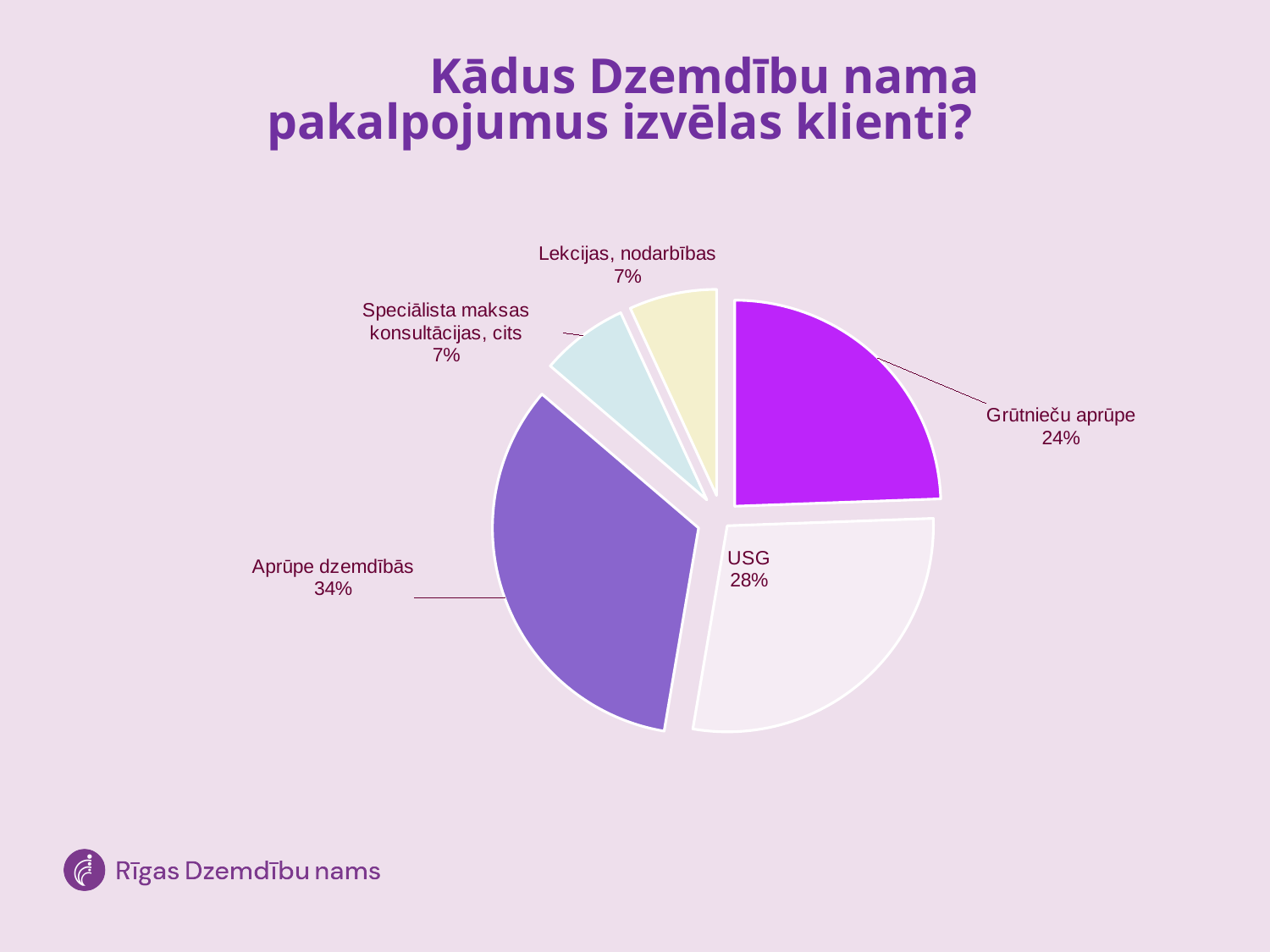
How many slices does the pie chart have? 5 What share of the pie does Aprūpe dzemdībās have? 34% What is the title of the chart on the slide? Kādus Dzemdību nama pakalpojumus izvēlas klienti? Which category has the largest slice of the pie? Aprūpe dzemdībās What kind of chart is shown on the slide? Pie chart What is the difference between the shares of Grūtnieču aprūpe and Lekcijas, nodarbības? 17% Which category is shown in the bright magenta slice? Grūtnieču aprūpe Which is larger, the share for USG or the share for Grūtnieču aprūpe? USG What is the value shown for Lekcijas, nodarbības? 7% What is the difference between the shares of Aprūpe dzemdībās and USG? 6% What is the value shown for USG? 28% What is the value shown for Grūtnieču aprūpe? 24%